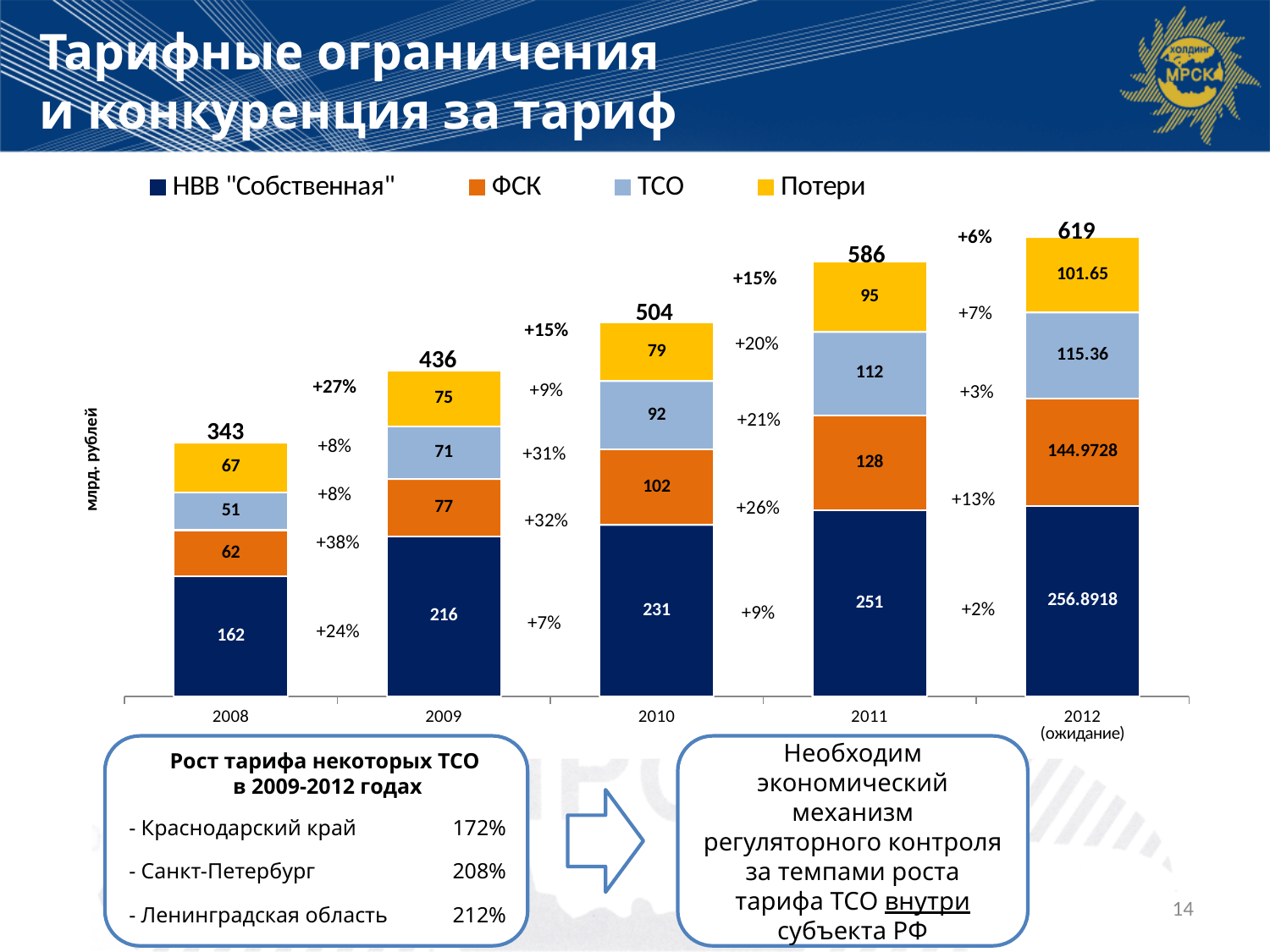
What is the value of НВВ "Собственная" for 2008? 162 What is the difference between the ФСК values for 2011 and 2010? 26 What is the value of Потери for 2011? 95 What is the value of ТСО for 2010? 92 Which year has the highest stacked bar total? 2012 (ожидание) Which year has the lowest stacked bar total? 2008 How many years are shown on the x axis? 5 What is the value of ФСК for 2012 (ожидание)? 144.9728 Which is larger, the ТСО value for 2009 or the Потери value for 2009? Потери (75) How many series does the legend list? 4 What kind of chart is shown on the slide? Stacked bar chart What is the total of the stacked bar for 2009? 436